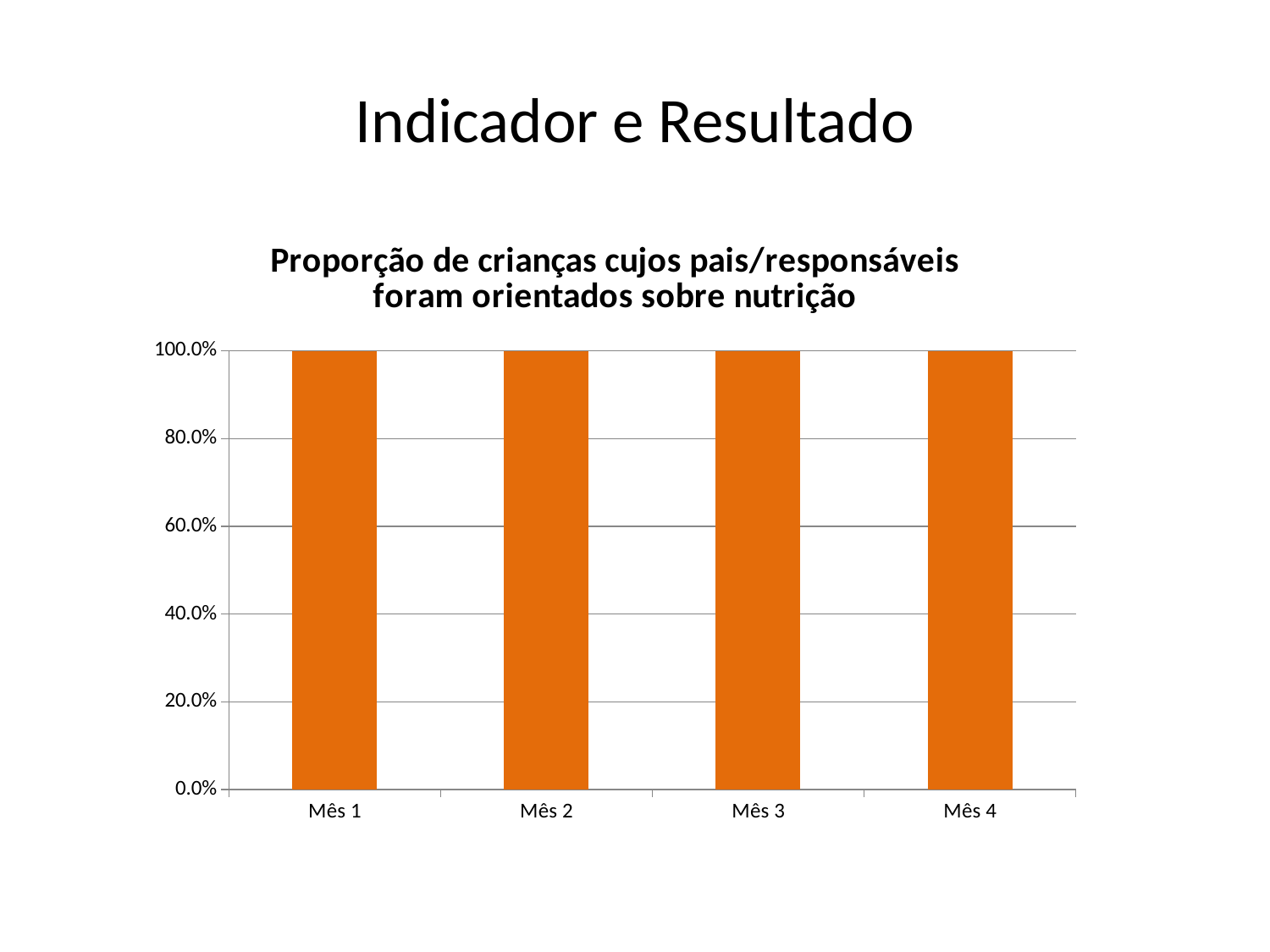
What is the value for Mês 4? 100.0% Do the values rise, fall, or stay flat from Mês 1 to Mês 4? stay flat What is the title of the chart? Proporção de crianças cujos pais/responsáveis foram orientados sobre nutrição What kind of chart is shown on the slide? bar chart What colour are the bars in the chart? orange How many categories are plotted on the x axis of the chart? 4 What is the difference between the values for Mês 1 and Mês 4? 0.0% What is the value for Mês 1? 100.0% What is the value for Mês 3? 100.0% What is the highest value shown on the y axis of the chart? 100.0% Is the value for Mês 2 greater or less than 80.0%? greater